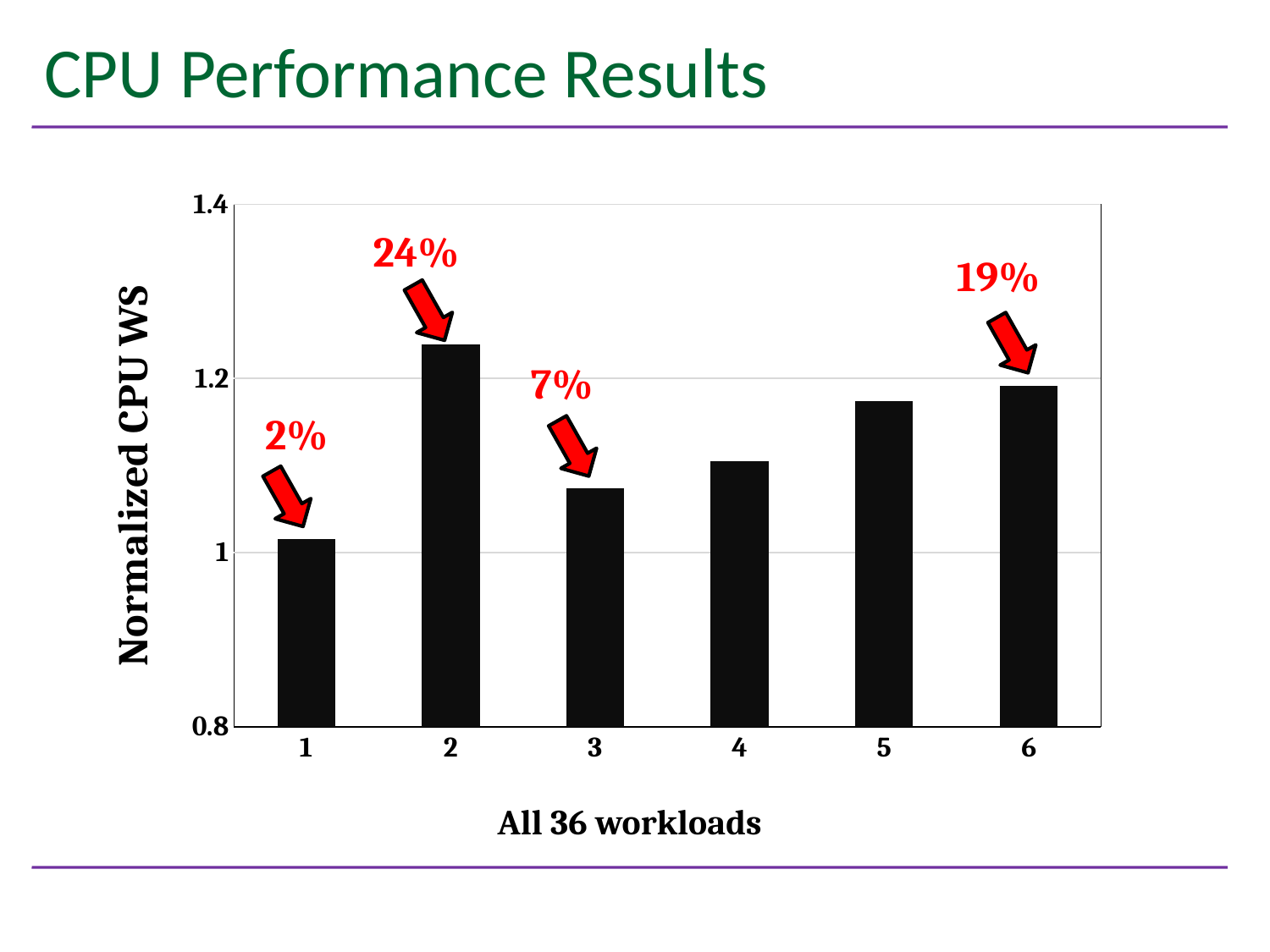
Is the value for category 3 greater or less than 1? greater What percentage is annotated above the bar for category 2? 24% Is the value for category 4 greater or less than 1.2? less What kind of chart is shown on the slide? bar chart Is the value for category 2 greater or less than 1.2? greater What percentage is annotated above the bar for category 6? 19% Which category has the highest Normalized CPU WS? 2 How many bars are plotted in the chart? 6 Which category has the lowest Normalized CPU WS? 1 Which is larger, the value for category 2 or category 6? 2 Which is larger, the value for category 4 or category 5? 5 What is the label of the y axis? Normalized CPU WS